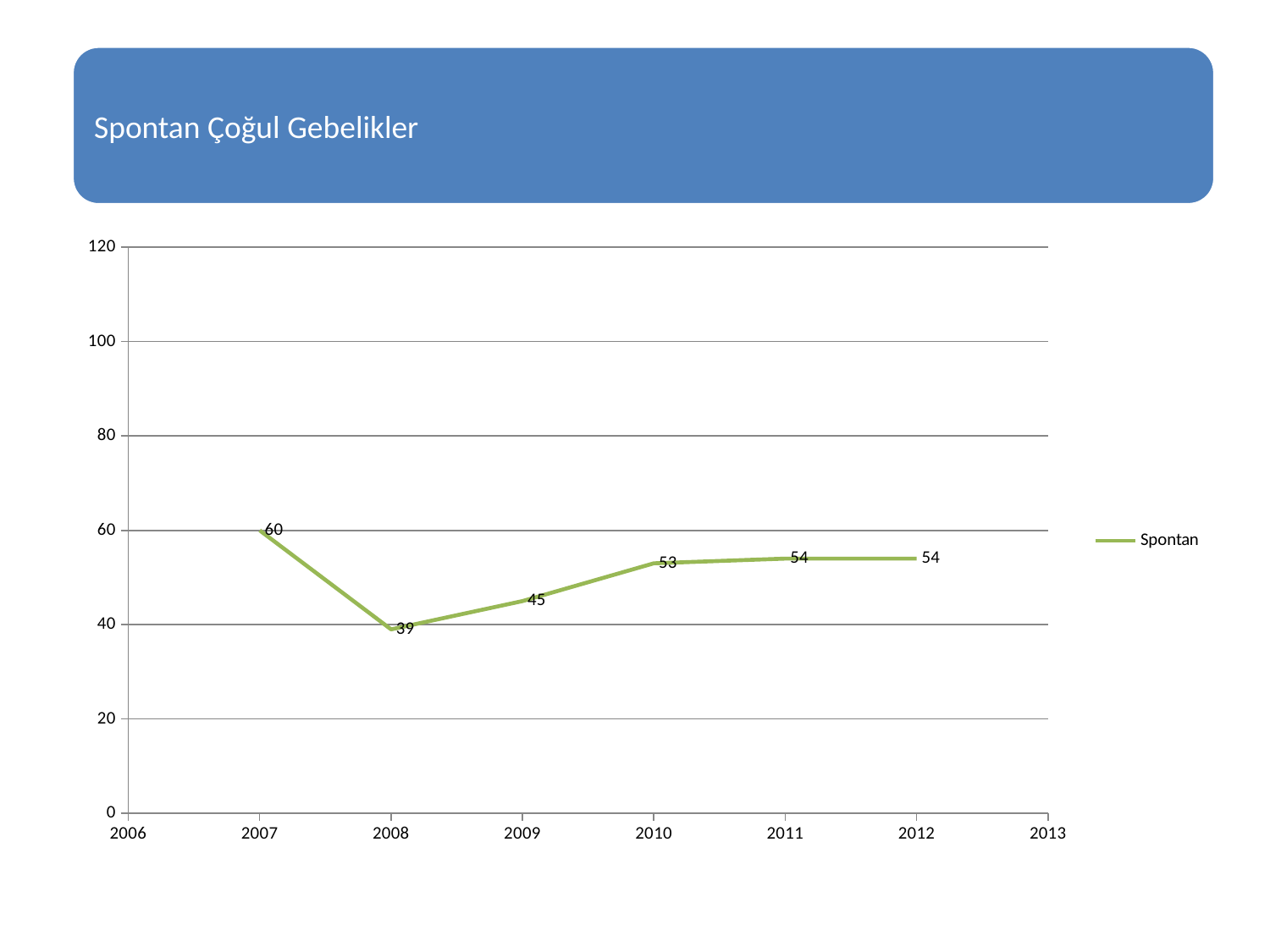
What is the value for 2010? 53 How many data points are plotted on the line? 6 Do the values rise or fall from 2008 to 2012? rise Which year has the highest value? 2007 Is the value for 2009 greater or less than 40? greater How many series does the legend list? 1 Which is larger, the value for 2009 or the value for 2010? 2010 What is the value for 2007? 60 Which year has the lowest value? 2008 What is the difference between the values for 2007 and 2008? 21 What is the value for 2008? 39 What kind of chart is shown? line chart